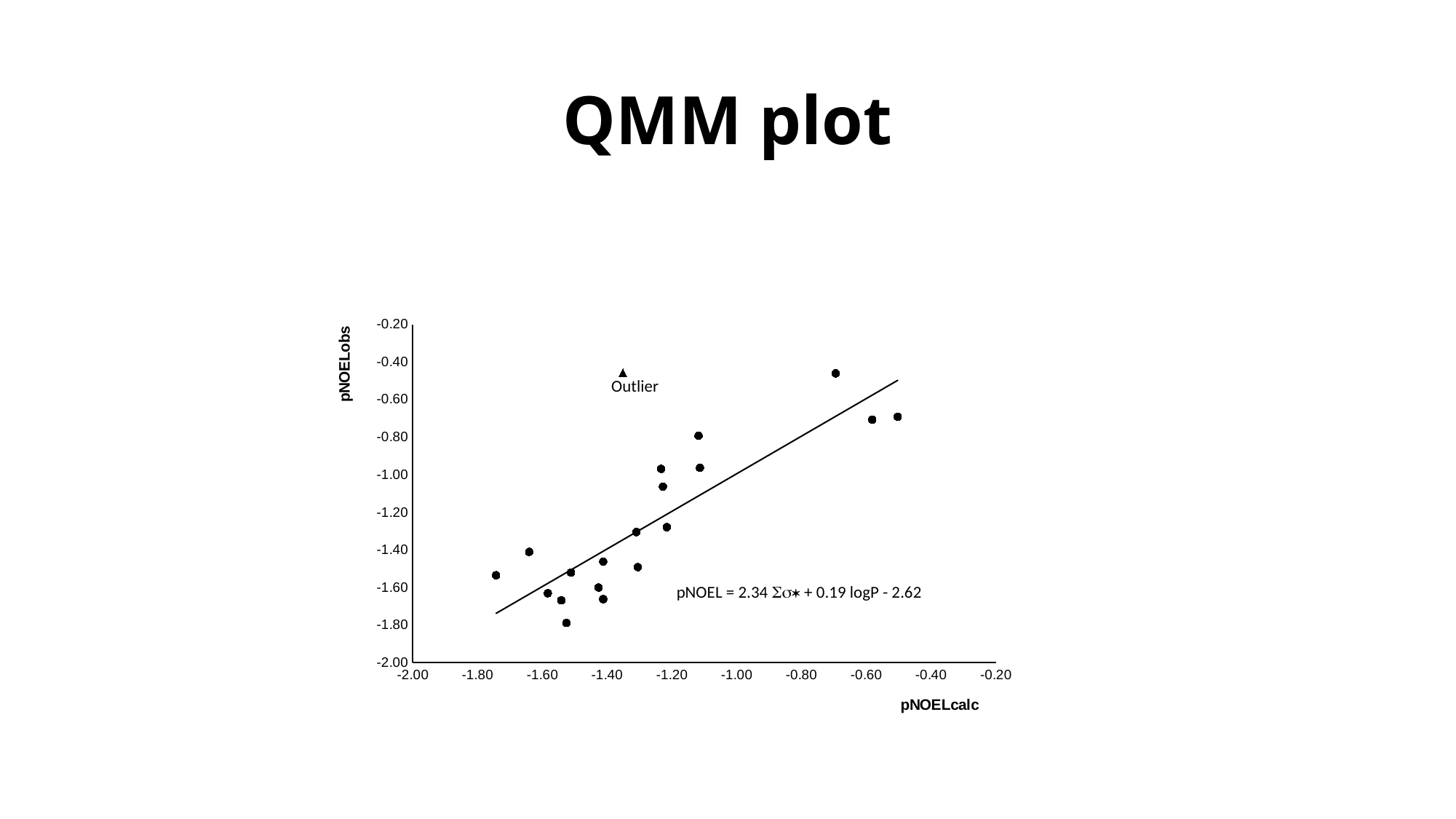
Is the pNOELcalc value of the point labelled Outlier greater or less than -1.20? less What is the title of the chart? QMM plot What label is attached to the triangular marker in the chart? Outlier What kind of chart is shown on the slide? scatter plot Is the pNOELcalc value of the rightmost point in the chart greater or less than -0.60? greater Is the pNOELobs value of the point labelled Outlier greater or less than -0.60? greater Do the pNOELobs values generally rise or fall as pNOELcalc increases along the x axis? rise